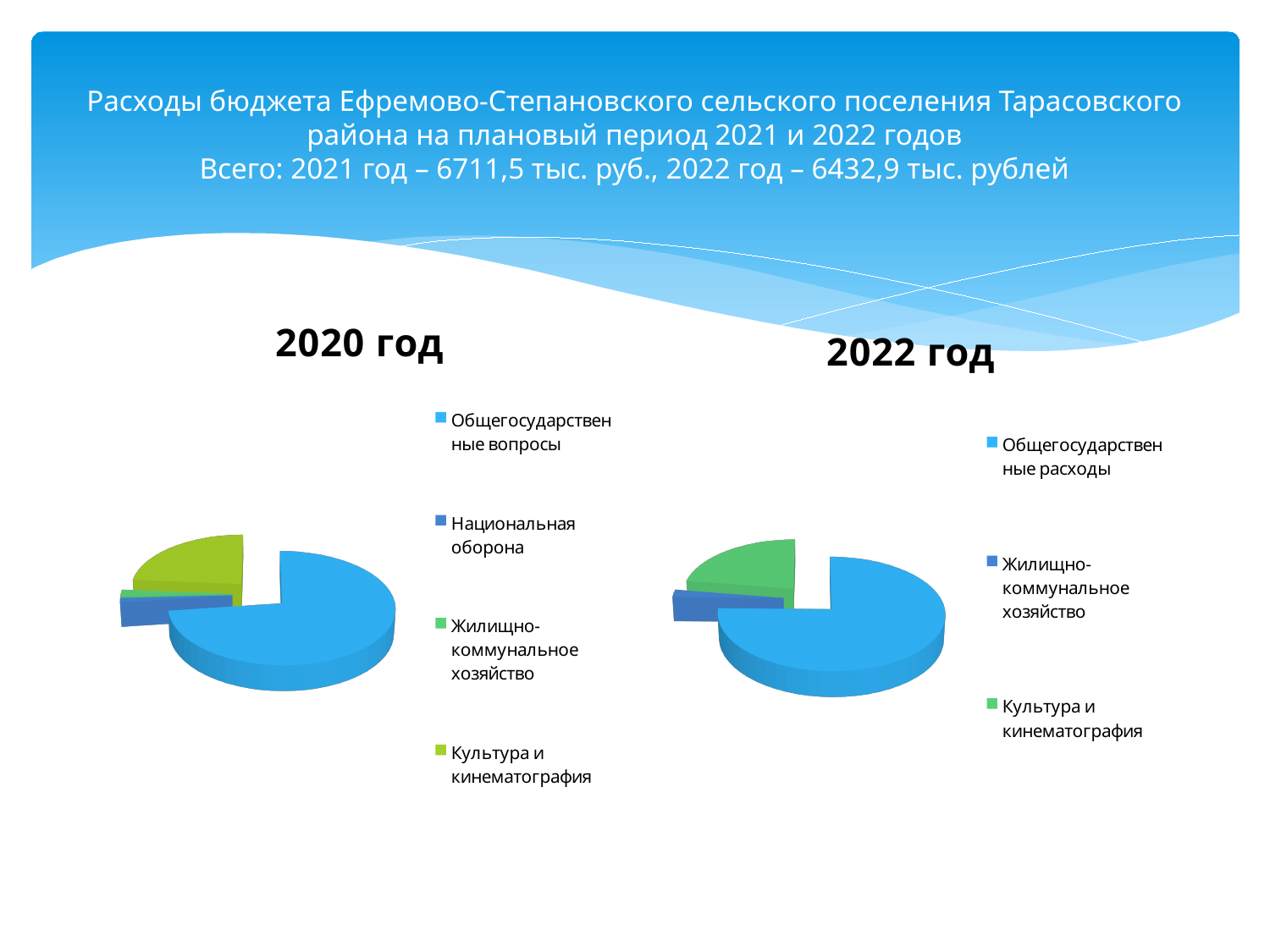
In the "2020 год" chart, which slice is larger: Общегосударственные вопросы or Культура и кинематография? Общегосударственные вопросы In the "2020 год" chart, which slice is larger: Культура и кинематография or Национальная оборона? Культура и кинематография In the "2022 год" chart, which slice is larger: Культура и кинематография or Жилищно-коммунальное хозяйство? Культура и кинематография What is the title of the chart on the right? 2022 год How many categories does the legend of the "2020 год" chart list? 4 What kind of chart is the "2020 год" chart on the left? pie chart How many categories does the legend of the "2022 год" chart list? 3 Which category is listed in the legend of the "2020 год" chart but not in the legend of the "2022 год" chart? Национальная оборона What kind of chart is the "2022 год" chart on the right? pie chart In the "2022 год" chart, which category has the smallest slice? Жилищно-коммунальное хозяйство In the "2022 год" chart, which category has the largest slice? Общегосударственные расходы In the "2020 год" chart, which category has the largest slice? Общегосударственные вопросы